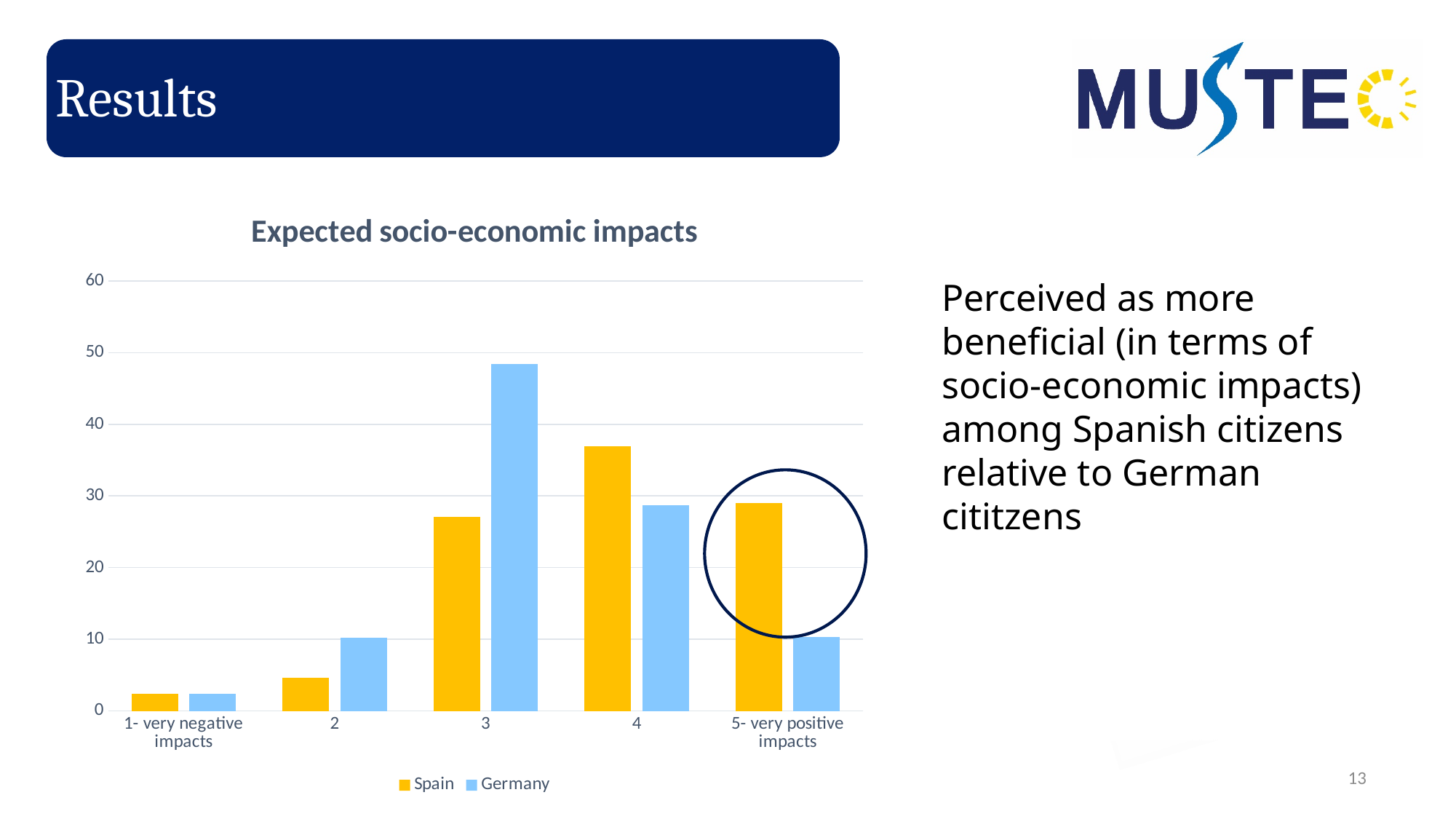
Is the value for Germany in category 3 greater or less than 40? greater Which category has the highest value for Germany? 3 For the category "5- very positive impacts", which series has the larger value, Spain or Germany? Spain What is the title of the chart? Expected socio-economic impacts How many series does the legend list? 2 What kind of chart is shown on the slide? bar chart Which colour represents Germany in the chart? light blue For category 3, which series has the larger value, Spain or Germany? Germany How many categories are shown on the x axis? 5 Is the value for Spain in category 4 greater or less than 30? greater Which category has the lowest value for Spain? 1- very negative impacts Which category has the highest value for Spain? 4